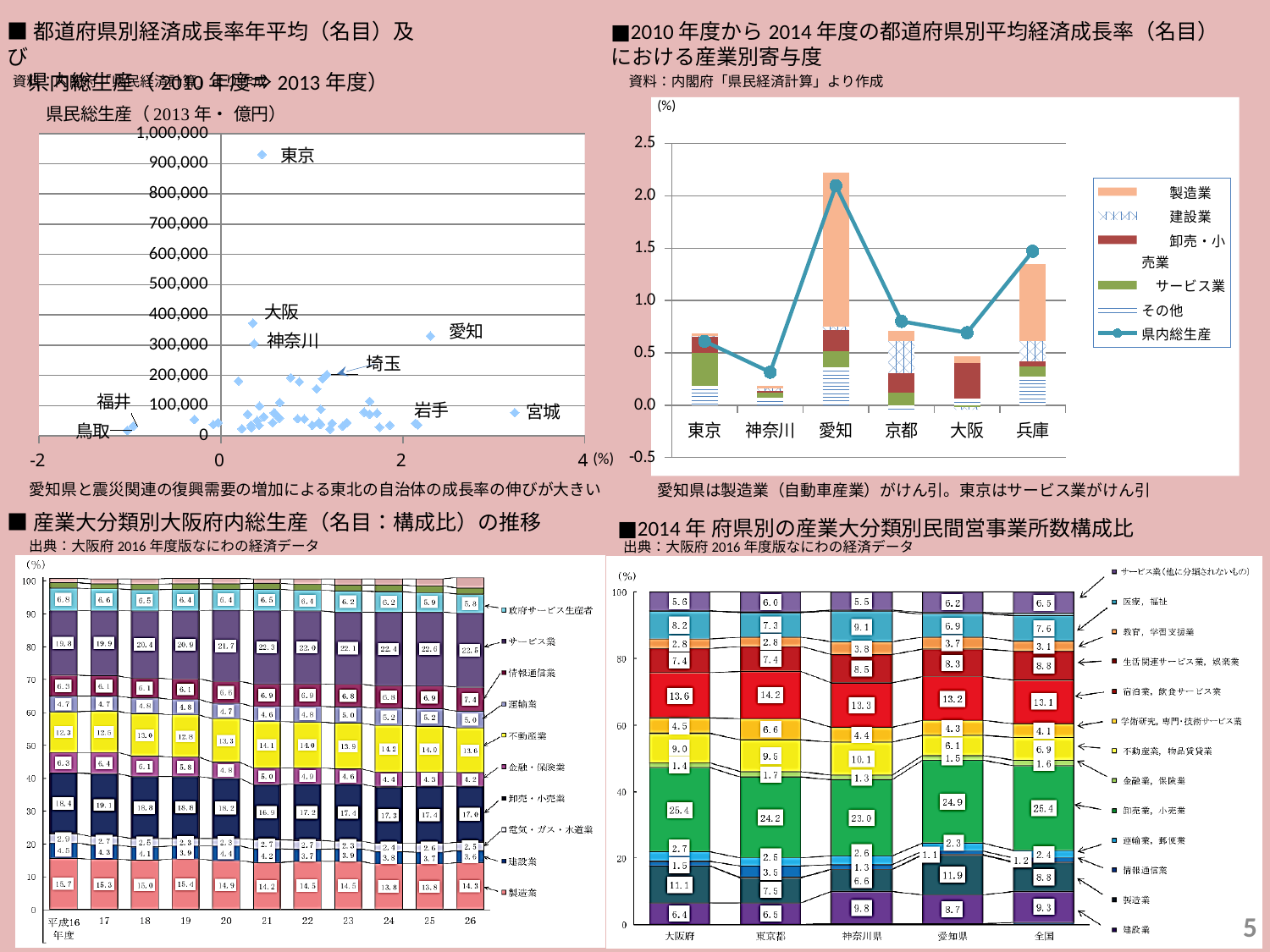
In the top-right chart, which prefecture has the highest 県内総生産 line value? 愛知 In the bottom-left chart (産業大分類別大阪府内総生産), what is the 製造業 value for 平成16年度? 15.7 In the top-right chart (産業別寄与度), how many prefectures are shown on the x axis? 6 In the bottom-right chart, what is the difference between the 卸売業,小売業 values for 大阪府 and 神奈川県? 2.4 In the top-right chart (産業別寄与度), how many entries does the legend list? 6 In the top-left chart, is the 県民総生産 value for 東京 greater or less than 900,000? greater In the bottom-right chart (府県別の産業大分類別民間営事業所数構成比), what is the 製造業 value for 愛知県? 11.9 In the top-right chart, is the 県内総生産 line value for 兵庫 greater or less than 1.0? greater In the bottom-right chart, which has the larger 建設業 value, 大阪府 or 神奈川県? 神奈川県 In the top-right chart, which prefecture has the lowest 県内総生産 line value? 神奈川 In the top-left chart (県民総生産 vs 経済成長率), what kind of chart is it? scatter chart In the bottom-left chart (産業大分類別大阪府内総生産), does the サービス業 share rise or fall from 平成16 to 26? rise